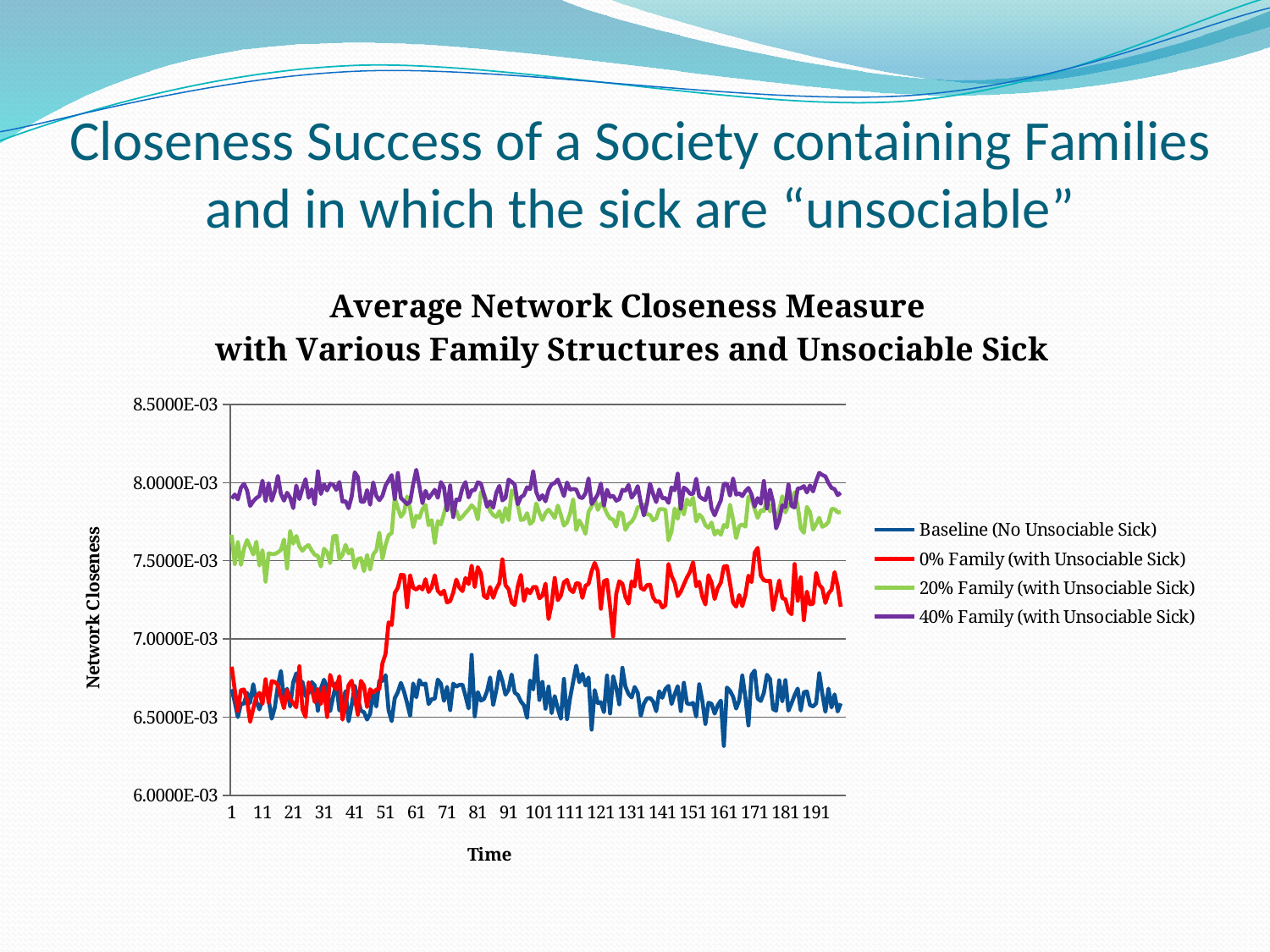
What is the label on the horizontal axis of the chart? Time At time 151, which series has the larger value: 0% Family (with Unsociable Sick) or Baseline (No Unsociable Sick)? 0% Family (with Unsociable Sick) Does the 0% Family (with Unsociable Sick) series rise or fall between time 41 and time 61? rise Which series has the lowest Network Closeness values across the time range? Baseline (No Unsociable Sick) Is the value for 40% Family (with Unsociable Sick) at time 1 greater or less than 7.5000E-03? greater Is the value for 0% Family (with Unsociable Sick) at time 11 greater or less than 7.0000E-03? less At time 101, which series has the larger value: 20% Family (with Unsociable Sick) or 40% Family (with Unsociable Sick)? 40% Family (with Unsociable Sick) What kind of chart is shown on the slide? line chart What is the label on the vertical axis of the chart? Network Closeness Is the value for Baseline (No Unsociable Sick) at time 101 greater or less than 7.0000E-03? less Which series has the highest Network Closeness values across the time range? 40% Family (with Unsociable Sick) How many series does the legend list? 4